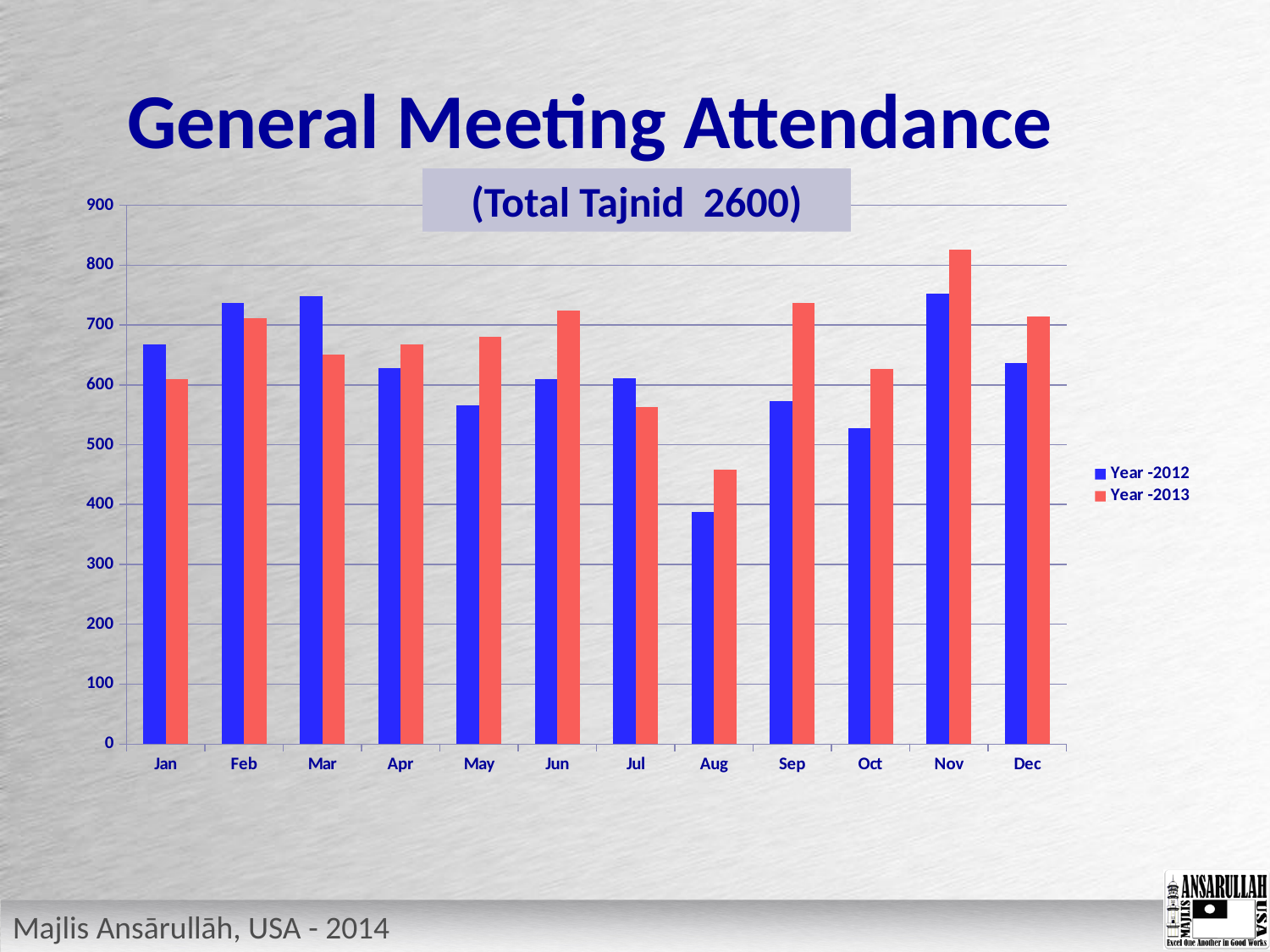
Which month has the lowest value for Year -2013? Aug What subtitle appears above the chart below the main title? (Total Tajnid 2600) In Jan, which series has the larger value, Year -2012 or Year -2013? Year -2012 How many series does the legend list? 2 What kind of chart is shown on the slide? bar chart Is the value for Year -2013 in Nov greater or less than 800? greater Which month has the highest value for Year -2013? Nov In Sep, which series has the larger value, Year -2012 or Year -2013? Year -2013 Is the value for Year -2013 in Sep greater or less than 700? greater Which month has the lowest value for Year -2012? Aug How many months are shown on the x axis? 12 Is the value for Year -2012 in Aug greater or less than 500? less